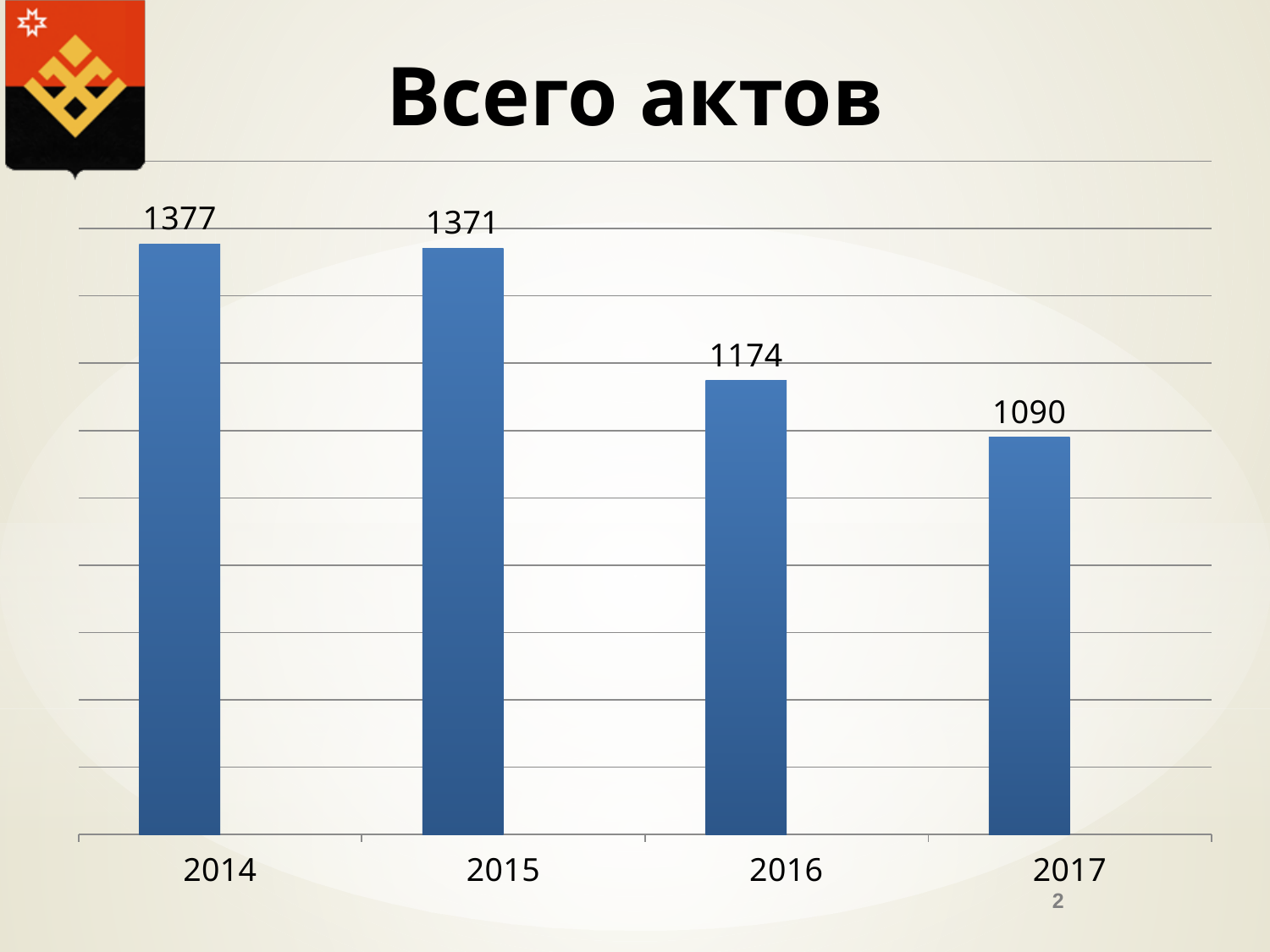
How many years are shown on the chart? 4 What is the title of the chart? Всего актов What is the difference between the values for 2015 and 2016? 197 What is the value for 2017? 1090 Which year has the lowest value? 2017 What is the difference between the values for 2014 and 2017? 287 What kind of chart is shown on the slide? bar chart Which year has the highest value? 2014 Do the values rise or fall from 2014 to 2017? fall Which is larger, the value for 2016 or the value for 2017? 2016 What is the value for 2016? 1174 What is the value for 2014? 1377